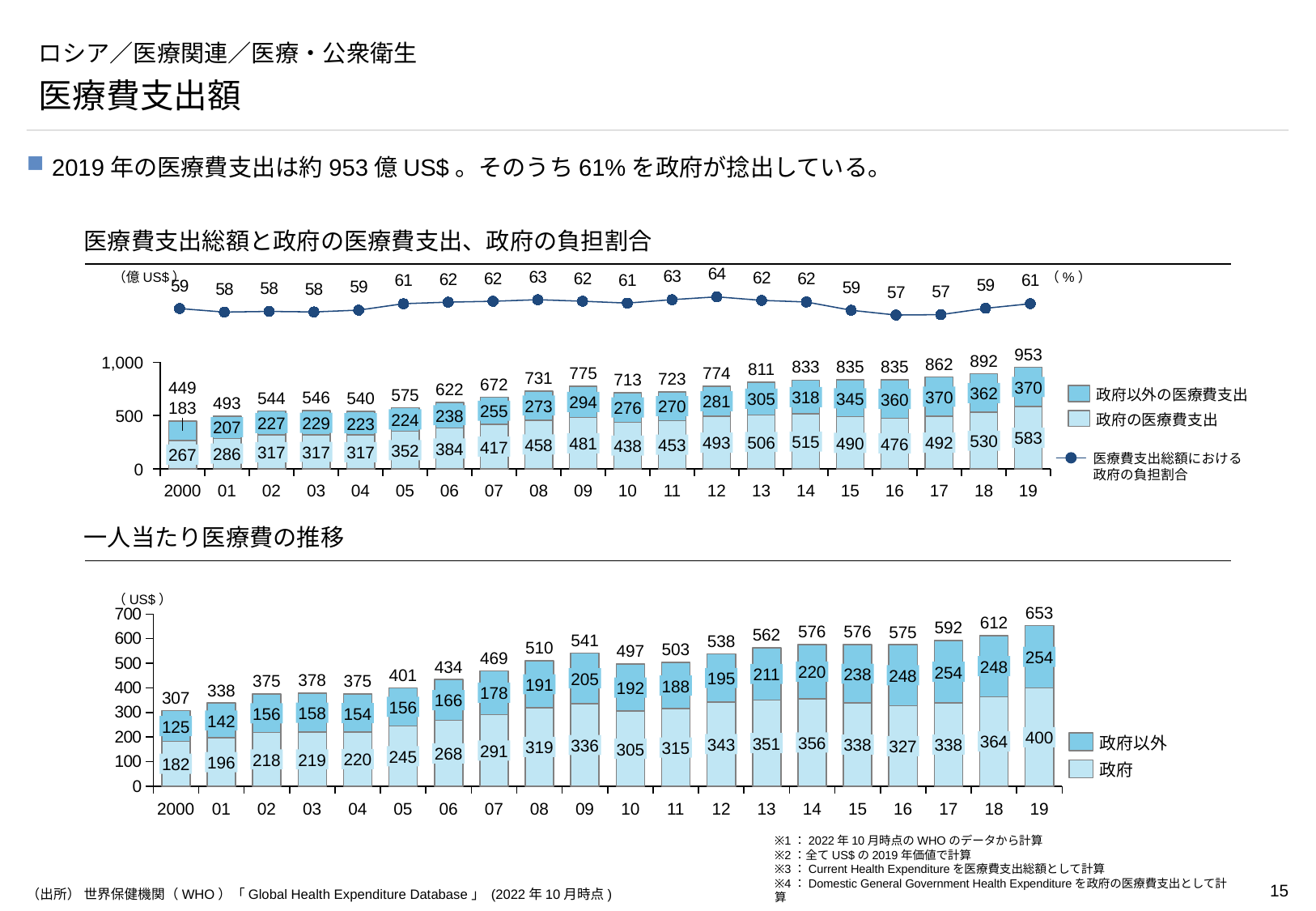
In the bottom chart, what is the government (政府) per-capita health expenditure for 2000? 182 In the top chart (医療費支出総額と政府の医療費支出、政府の負担割合), what is the total health expenditure for 2019? 953 In the bottom chart, how many years are shown on the x axis? 20 In the top chart, what is the government health expenditure (政府の医療費支出) for 2019? 583 In the top chart, which year has the larger total health expenditure, 2009 or 2010? 2009 In the bottom chart, how many series does the legend list? 2 In the bottom chart (一人当たり医療費の推移), what is the per-capita health expenditure for 2019? 653 In the top chart, in which year is the government share of total health expenditure highest? 2012 In the bottom chart, what is the difference between the per-capita totals for 2019 and 2018? 41 In the top chart, what is the government share of total health expenditure (政府の負担割合) in 2012? 64 In the top chart, in which year is the total health expenditure lowest? 2000 In the top chart, what is the difference between government health expenditure in 2019 and 2018? 53